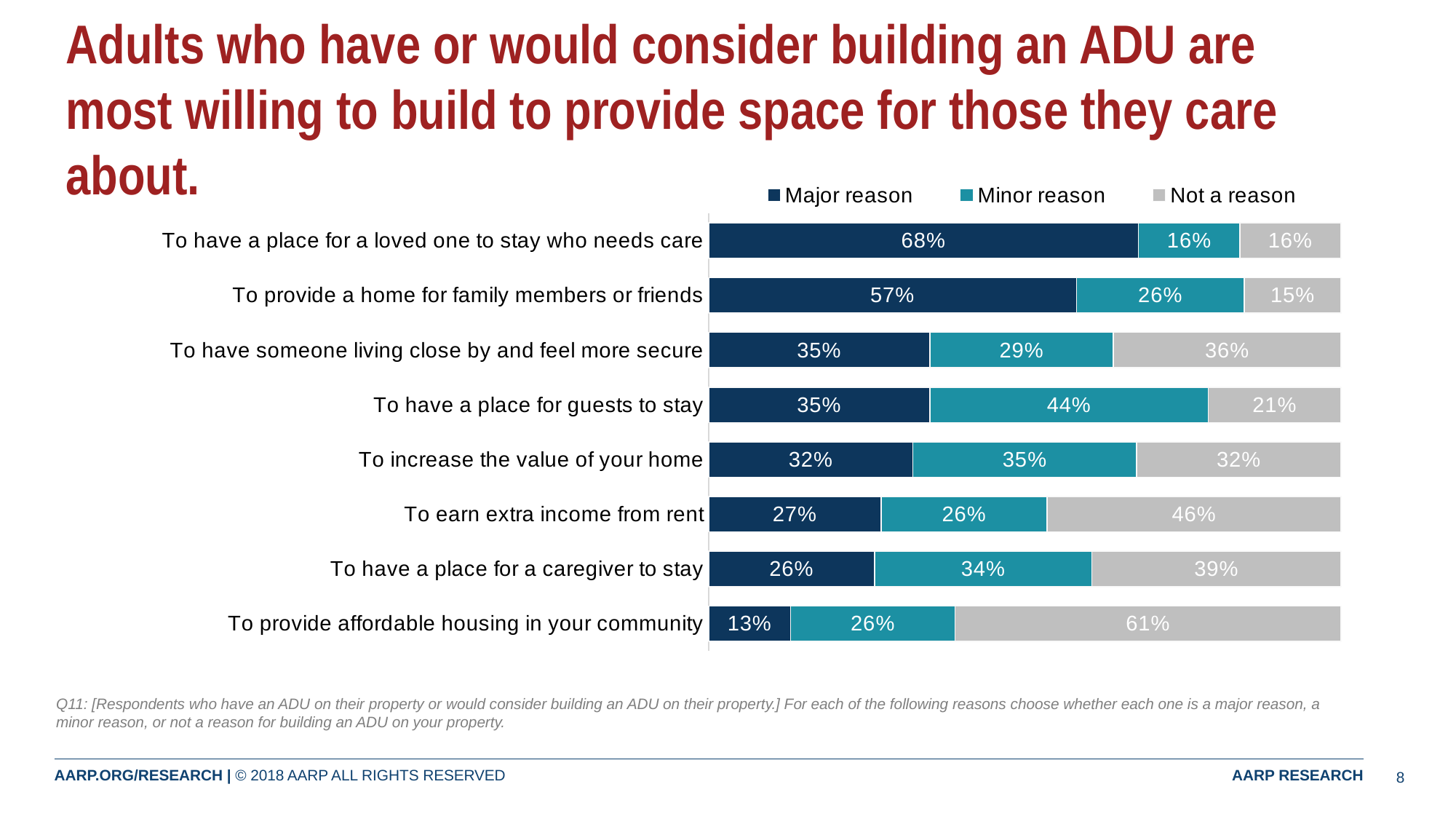
Which category has the highest 'Major reason' percentage? To have a place for a loved one to stay who needs care What is the total of the stacked bar for 'To have someone living close by and feel more secure'? 100% How many categories (reasons) are shown in the chart? 8 What percentage said 'To have a place for a loved one to stay who needs care' is a major reason? 68% Which is larger: the 'Not a reason' value for 'To earn extra income from rent' or for 'To have a place for a caregiver to stay'? To earn extra income from rent How many series does the legend list? 3 What is the 'Minor reason' value for 'To have a place for guests to stay'? 44% What is the difference between the 'Major reason' values for 'To have a place for a loved one to stay who needs care' and 'To provide a home for family members or friends'? 11% What percentage said 'To provide affordable housing in your community' is not a reason? 61% What kind of chart is shown on the slide? Stacked bar chart Which category has the lowest 'Major reason' percentage? To provide affordable housing in your community Which series is shown in the lightest (grey) colour in the legend? Not a reason